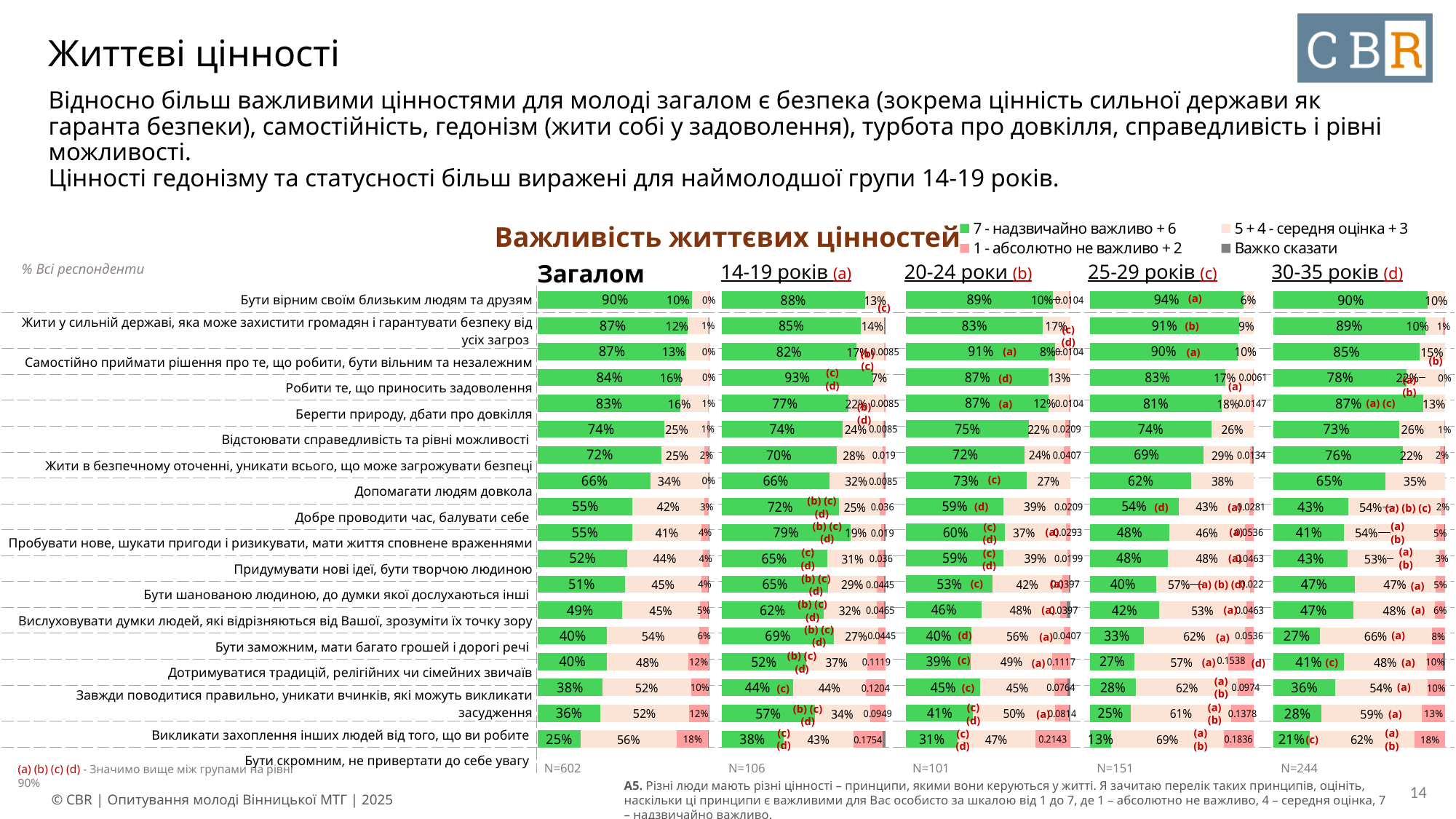
In the Загалом panel, which life value has the lowest 7 + 6 share? Бути скромним, не привертати до себе увагу What kind of chart is shown on the slide? Stacked bar chart What is the title of the chart? Важливість життєвих цінностей In the Загалом panel, what is the difference between the 7 + 6 share for 'Бути заможним, мати багато грошей і дорогі речі' and the 5 + 4 share for the same value? 14% In the Загалом panel, what share rated 'Бути вірним своїм близьким людям та друзям' as 7 + 6 (extremely important)? 90% In the 14-19 років panel, what is the 7 + 6 share for 'Робити те, що приносить задоволення'? 93% How many series does the legend of the chart list? 4 For 'Бути заможним, мати багато грошей і дорогі речі', which group has the larger 7 + 6 share: 14-19 років or 30-35 років? 14-19 років In the 25-29 років panel, which life value has the highest 7 + 6 share? Бути вірним своїм близьким людям та друзям What is the sample size (N) shown for the 30-35 років panel? N=244 How many life values (categories) are listed in the chart? 18 In the 25-29 років panel, what is the 7 + 6 share for 'Бути скромним, не привертати до себе увагу'? 13%